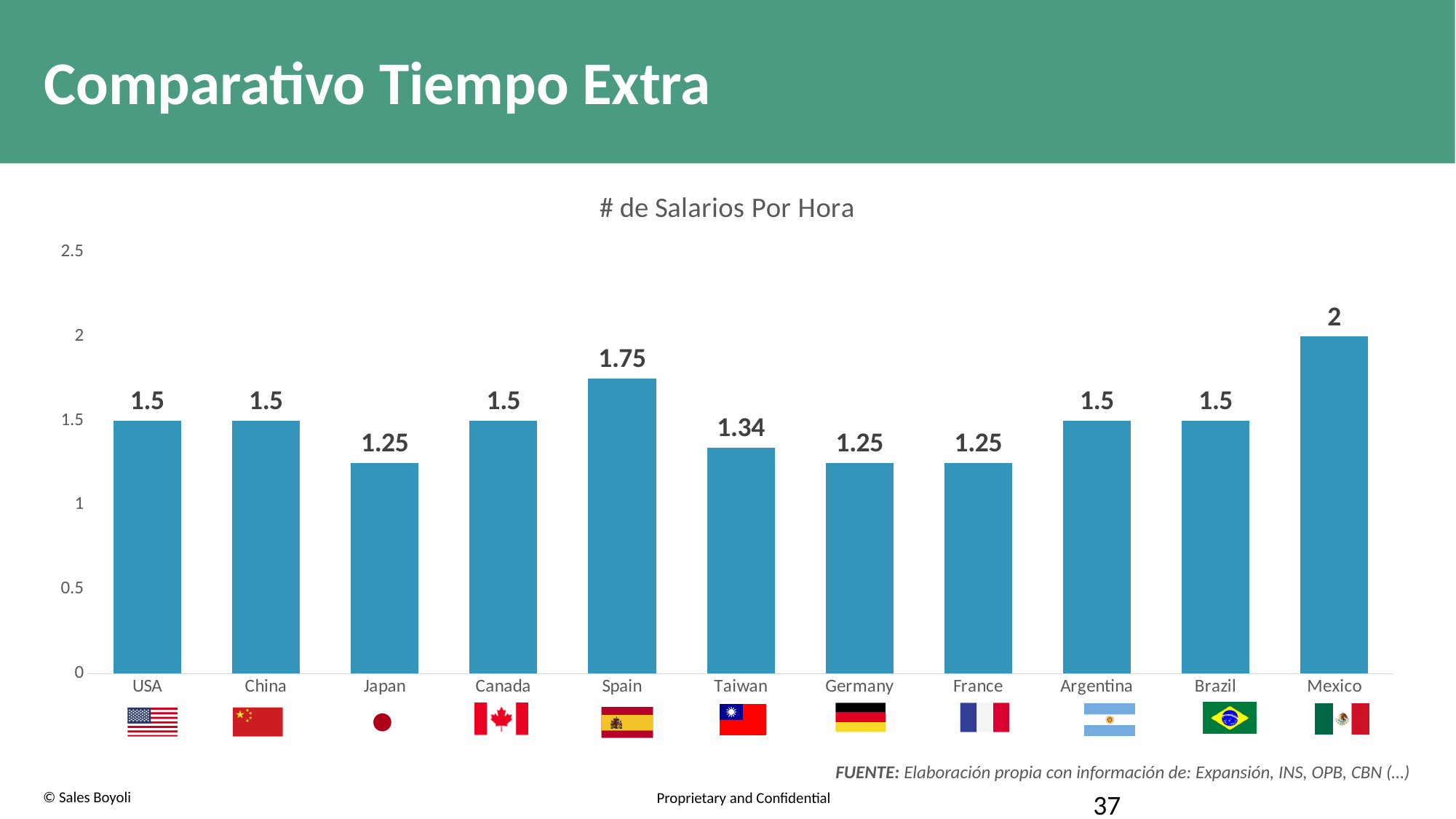
Which is larger, the value for Spain or the value for Canada? Spain What is the value for Germany? 1.25 Which is larger, the value for Taiwan or the value for France? Taiwan What is the difference between the values for Taiwan and Japan? 0.09 Which country has the highest value? Mexico Is the value for Mexico greater or less than 1.5? greater What is the value for Spain? 1.75 What is the value for Taiwan? 1.34 What kind of chart is shown on the slide? Bar chart What is the title of the chart? # de Salarios Por Hora What is the difference between the values for Mexico and Spain? 0.25 How many countries are shown on the chart? 11